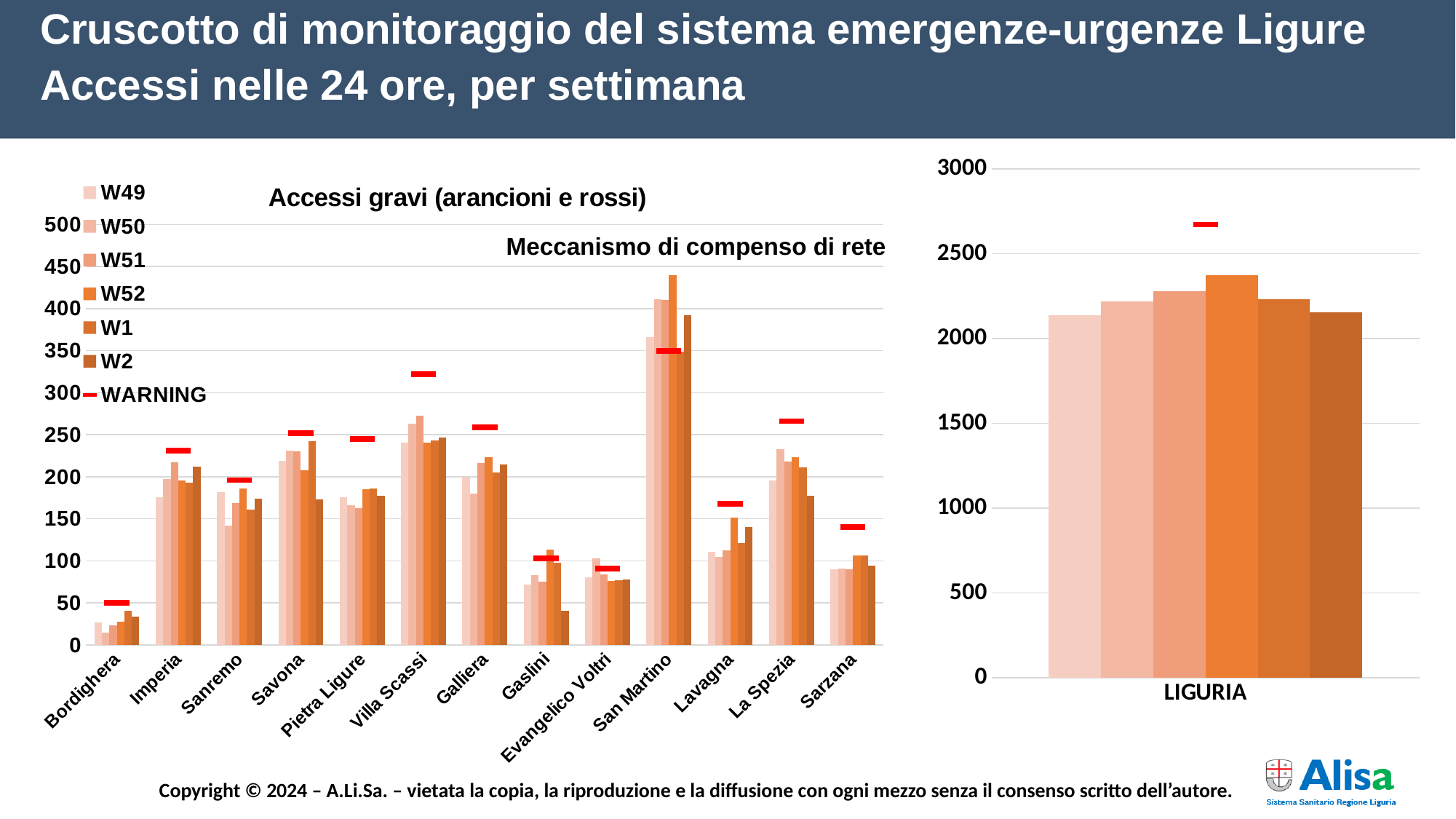
On the left chart, is the W52 value for San Martino greater or less than 400? greater What kind of chart is the left chart? bar chart On the left chart, is the W1 value for Savona greater or less than 200? greater On the left chart, which is larger for Gaslini: the W49 value or the W2 value? W49 On the right chart (LIGURIA), is the W49 value greater or less than 2000? greater On the left chart, how many entries does the legend list? 7 On the left chart, how many hospitals are shown on the x axis? 13 On the left chart, which hospital has the highest bars? San Martino On the right chart (LIGURIA), which week has the highest bar? W52 On the left chart, which hospital has the lowest bars? Bordighera